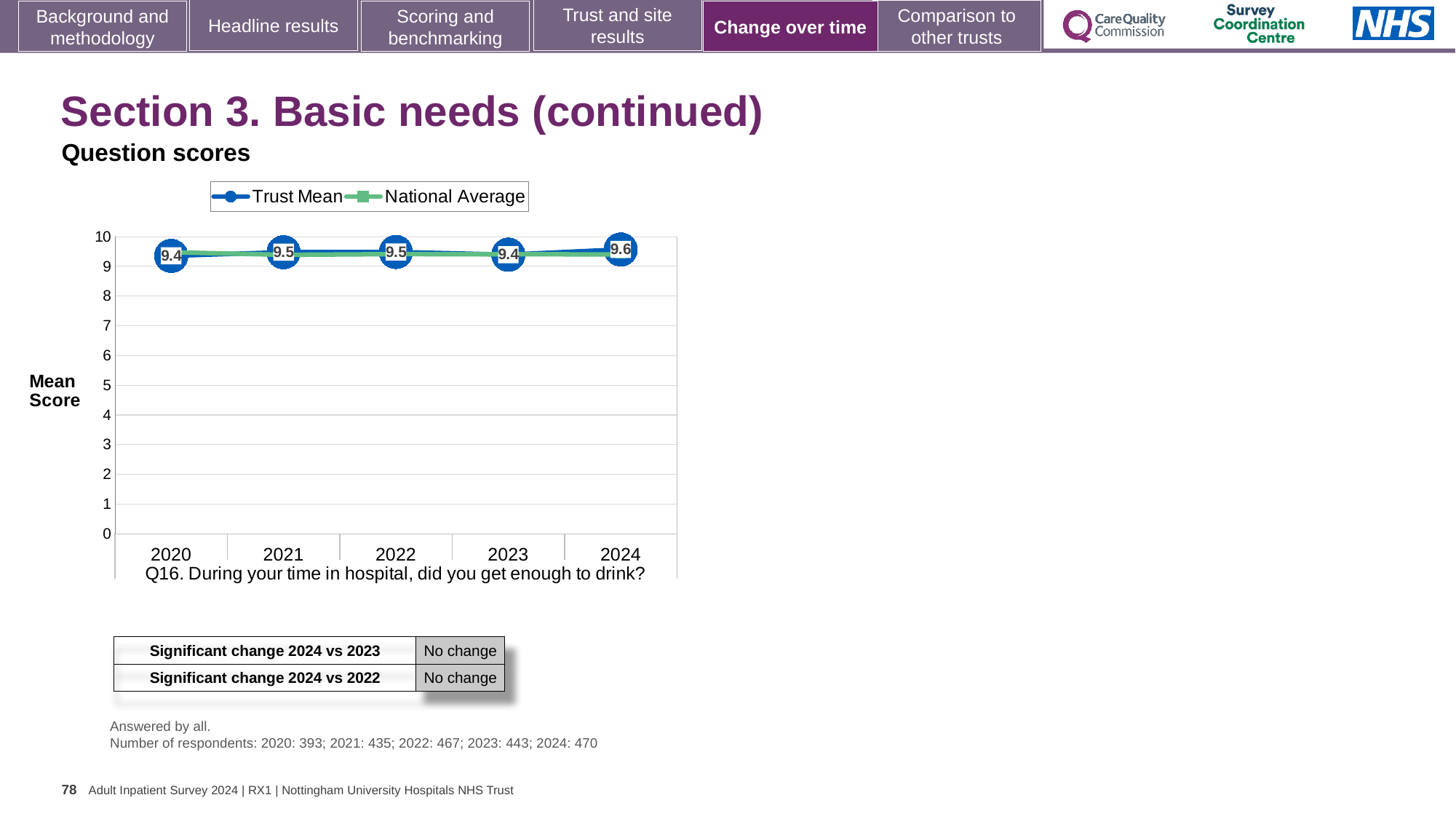
Is the National Average value for 2022 greater or less than 9? greater How many years are plotted on the x axis? 5 Does the Trust Mean score rise or fall from 2020 to 2024 overall? Rise What is the Trust Mean score for 2022? 9.5 What kind of chart is shown on the slide? Line chart In which year is the Trust Mean score highest? 2024 How many series does the legend list? 2 What is the label on the y axis of the chart? Mean Score What is the Trust Mean score for 2024? 9.6 What is the Trust Mean score for 2020? 9.4 What is the difference between the Trust Mean scores for 2024 and 2023? 0.2 Which year has the larger Trust Mean score, 2021 or 2024? 2024